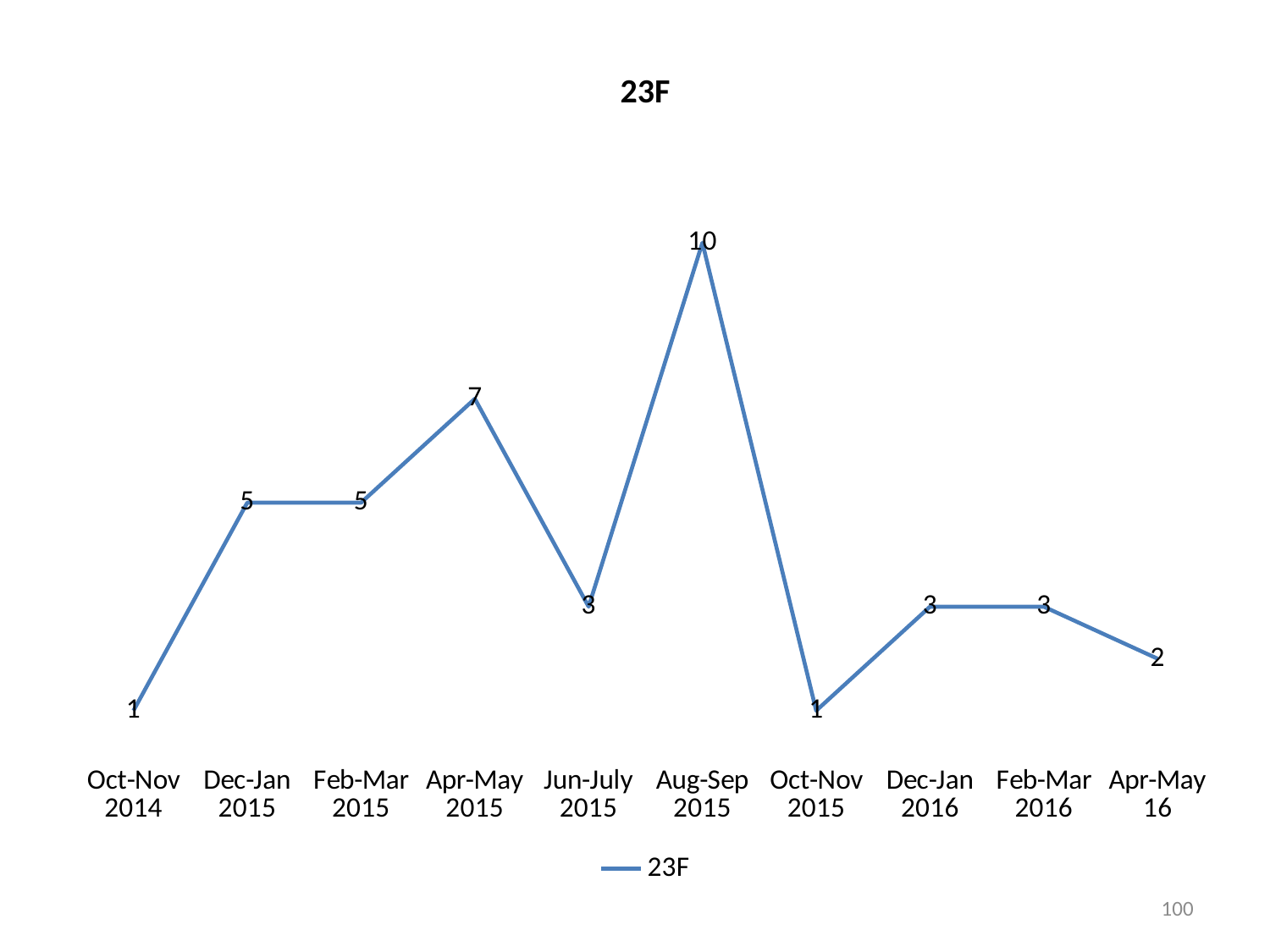
What is the difference between the values for Apr-May 2015 and Jun-July 2015? 4 Which is larger, the value for Dec-Jan 2015 or the value for Dec-Jan 2016? Dec-Jan 2015 How many series does the legend list? 1 What kind of chart is shown? line chart What is the value for Aug-Sep 2015? 10 How many periods are plotted on the x axis? 10 Which period has the highest value? Aug-Sep 2015 What is the value for Jun-July 2015? 3 What is the value for Apr-May 16? 2 What is the difference between the values for Aug-Sep 2015 and Oct-Nov 2015? 9 What is the value for Apr-May 2015? 7 What is the title of the chart? 23F